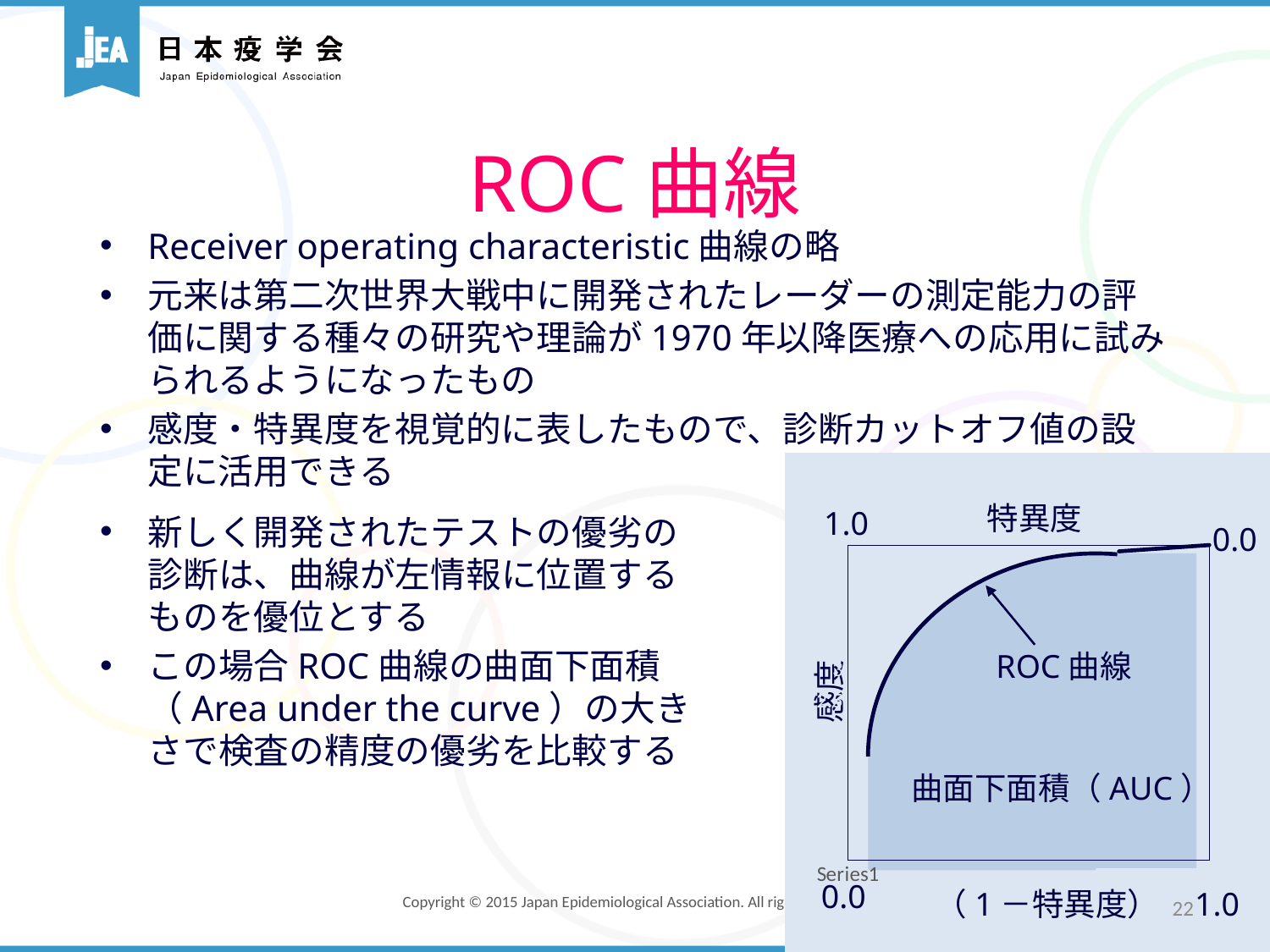
Does the ROC curve rise or fall as you move from left to right along the x axis? rise What label is shown on the x axis at the bottom of the chart? （1－特異度） What does the label inside the shaded area under the curve say? 曲面下面積（AUC） What kind of chart is shown on the slide? line chart